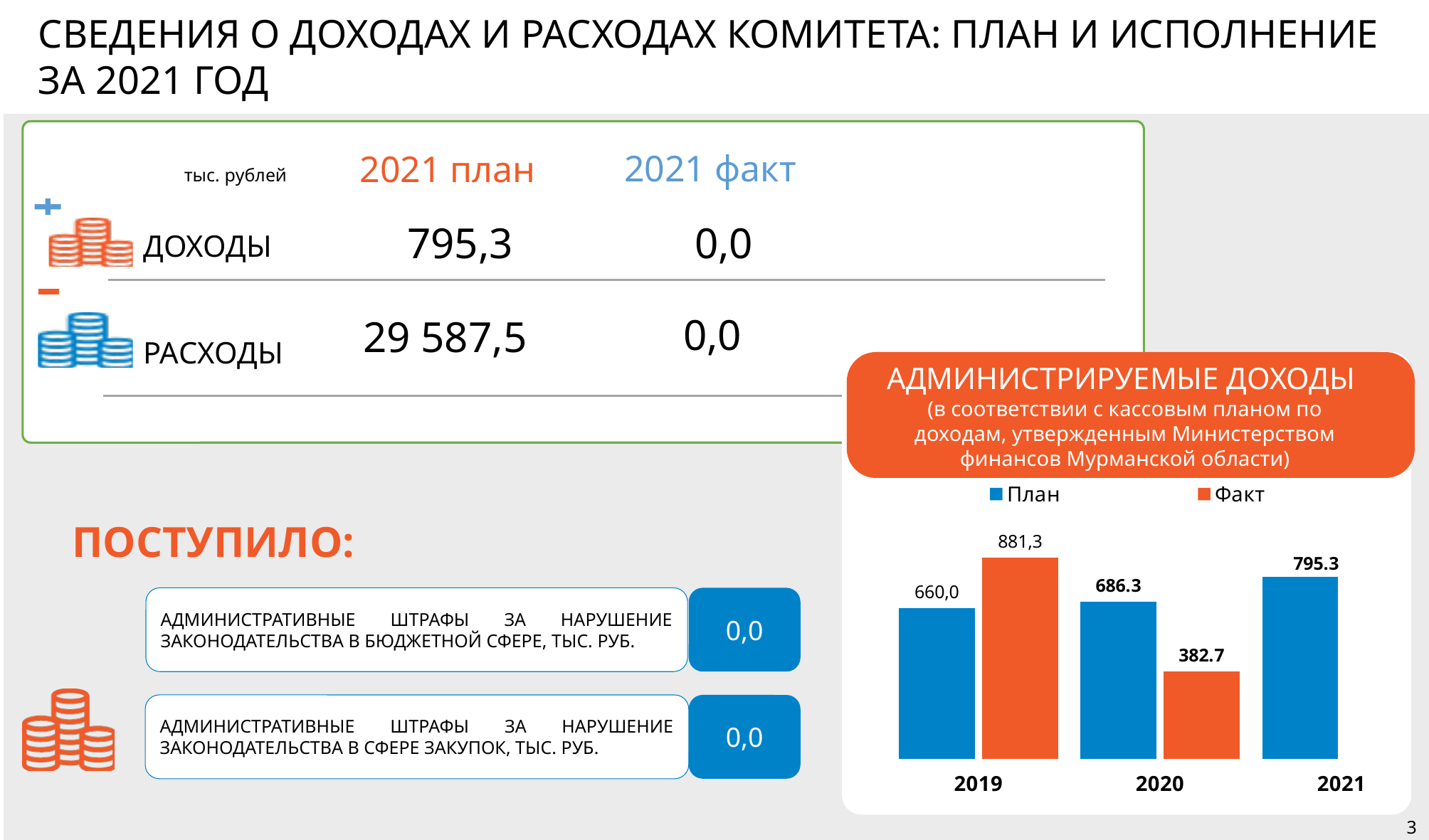
In the chart "АДМИНИСТРИРУЕМЫЕ ДОХОДЫ", which is larger for 2020, План or Факт? План In the chart "АДМИНИСТРИРУЕМЫЕ ДОХОДЫ", which year has the highest План value? 2021 In the chart "АДМИНИСТРИРУЕМЫЕ ДОХОДЫ", which year has the lowest Факт value among the years with a Факт bar? 2020 In the chart "АДМИНИСТРИРУЕМЫЕ ДОХОДЫ", what is the План value for 2021? 795.3 What kind of chart is "АДМИНИСТРИРУЕМЫЕ ДОХОДЫ"? Bar chart In the chart "АДМИНИСТРИРУЕМЫЕ ДОХОДЫ", what is the План value for 2019? 660,0 How many years are shown on the x axis of the chart "АДМИНИСТРИРУЕМЫЕ ДОХОДЫ"? 3 In the chart "АДМИНИСТРИРУЕМЫЕ ДОХОДЫ", what is the Факт value for 2020? 382.7 In the chart "АДМИНИСТРИРУЕМЫЕ ДОХОДЫ", what is the difference between the Факт and План values for 2019? 221,3 How many series does the legend of the chart "АДМИНИСТРИРУЕМЫЕ ДОХОДЫ" list? 2 In the chart "АДМИНИСТРИРУЕМЫЕ ДОХОДЫ", what is the Факт value for 2019? 881,3 In the chart "АДМИНИСТРИРУЕМЫЕ ДОХОДЫ", what is the difference between the План and Факт values for 2020? 303.6